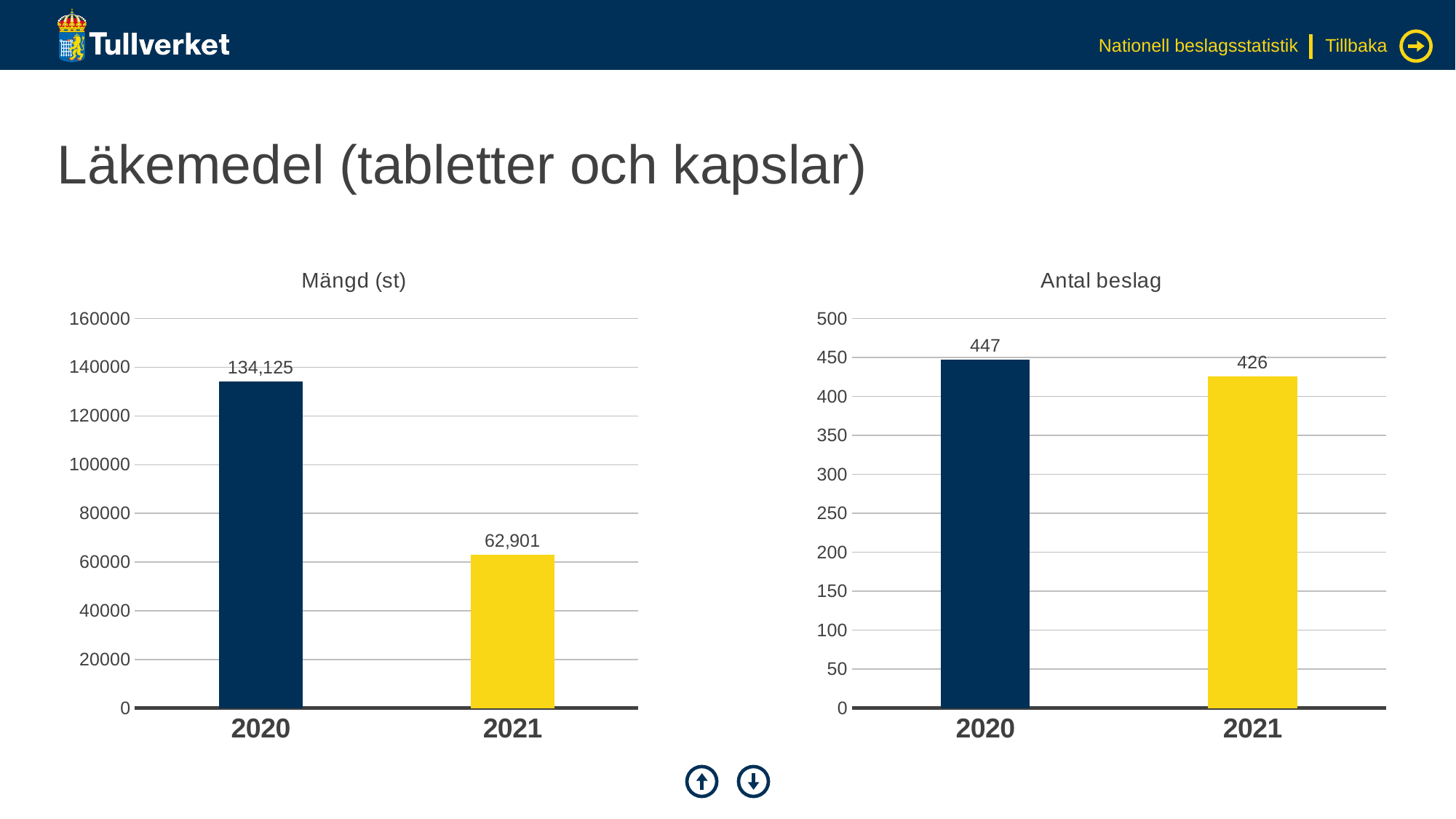
In the 'Mängd (st)' chart, what is the value for 2021? 62,901 In the 'Antal beslag' chart, which year has the lowest value? 2021 In the 'Antal beslag' chart, what is the value for 2021? 426 What kind of chart is the 'Mängd (st)' chart? bar chart In the 'Antal beslag' chart, what is the value for 2020? 447 In the 'Mängd (st)' chart, what is the value for 2020? 134,125 In the 'Mängd (st)' chart, do the values rise or fall from 2020 to 2021? fall In the 'Mängd (st)' chart, which year has the highest value? 2020 In the 'Antal beslag' chart, what is the difference between the 2020 and 2021 values? 21 How many bars are shown in the 'Antal beslag' chart? 2 In the 'Mängd (st)' chart, what is the difference between the 2020 and 2021 values? 71,224 In the 'Antal beslag' chart, is the value for 2021 greater or less than 400? greater